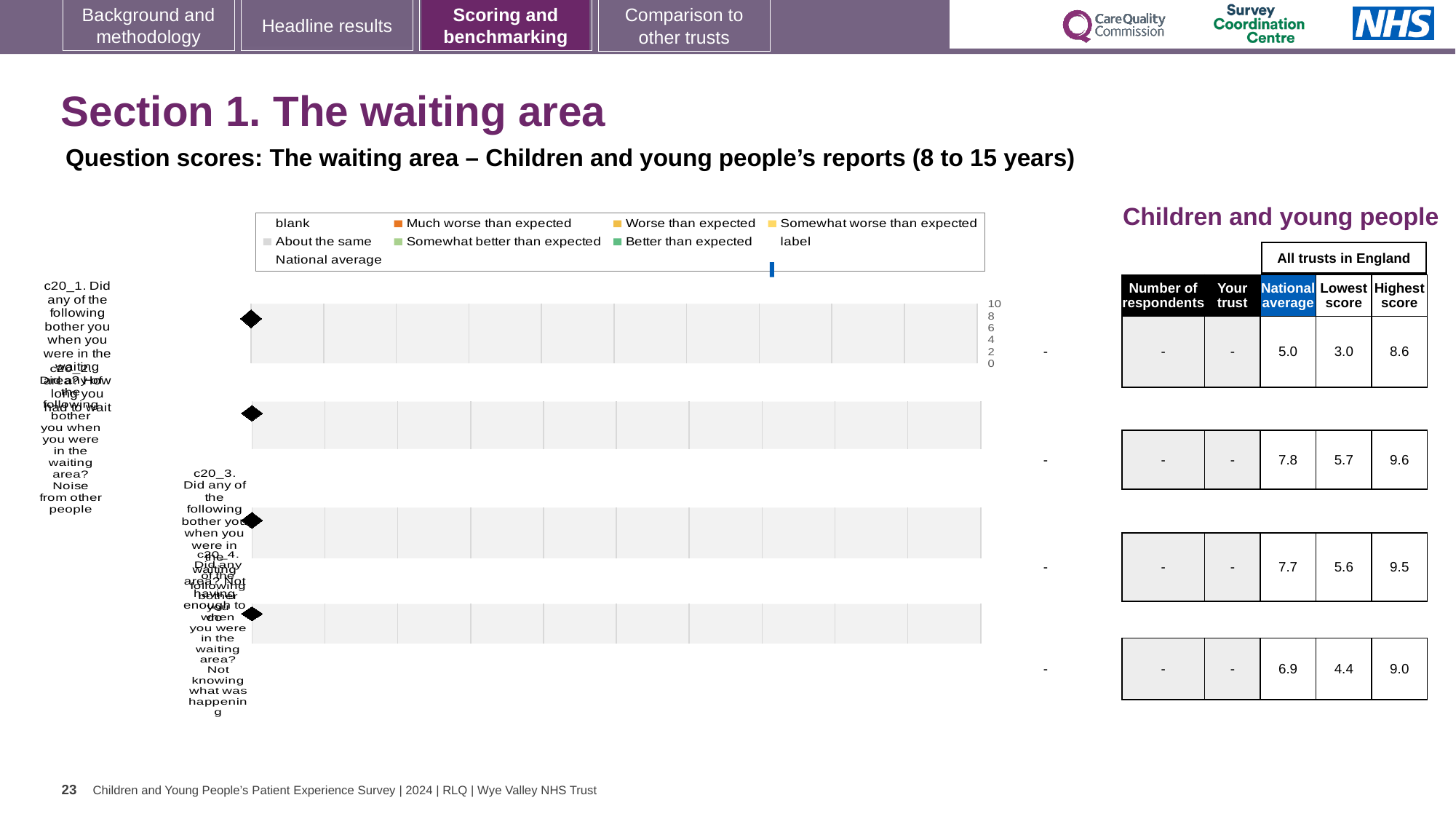
How many question categories (bars) does the chart show? 4 What is the highest value shown on the chart's axis? 10 What is the national average score for question c20_2? 7.8 Is the national average score for c20_3 greater or less than 6? greater What is the national average score for question c20_4? 6.9 What kind of chart is shown on the slide? bar chart What is the national average score for question c20_1? 5.0 Which question has the lowest national average score? c20_1 What is the difference between the national average scores for c20_2 and c20_1? 2.8 How many entries does the chart's legend list? 9 Which question has the highest national average score? c20_2